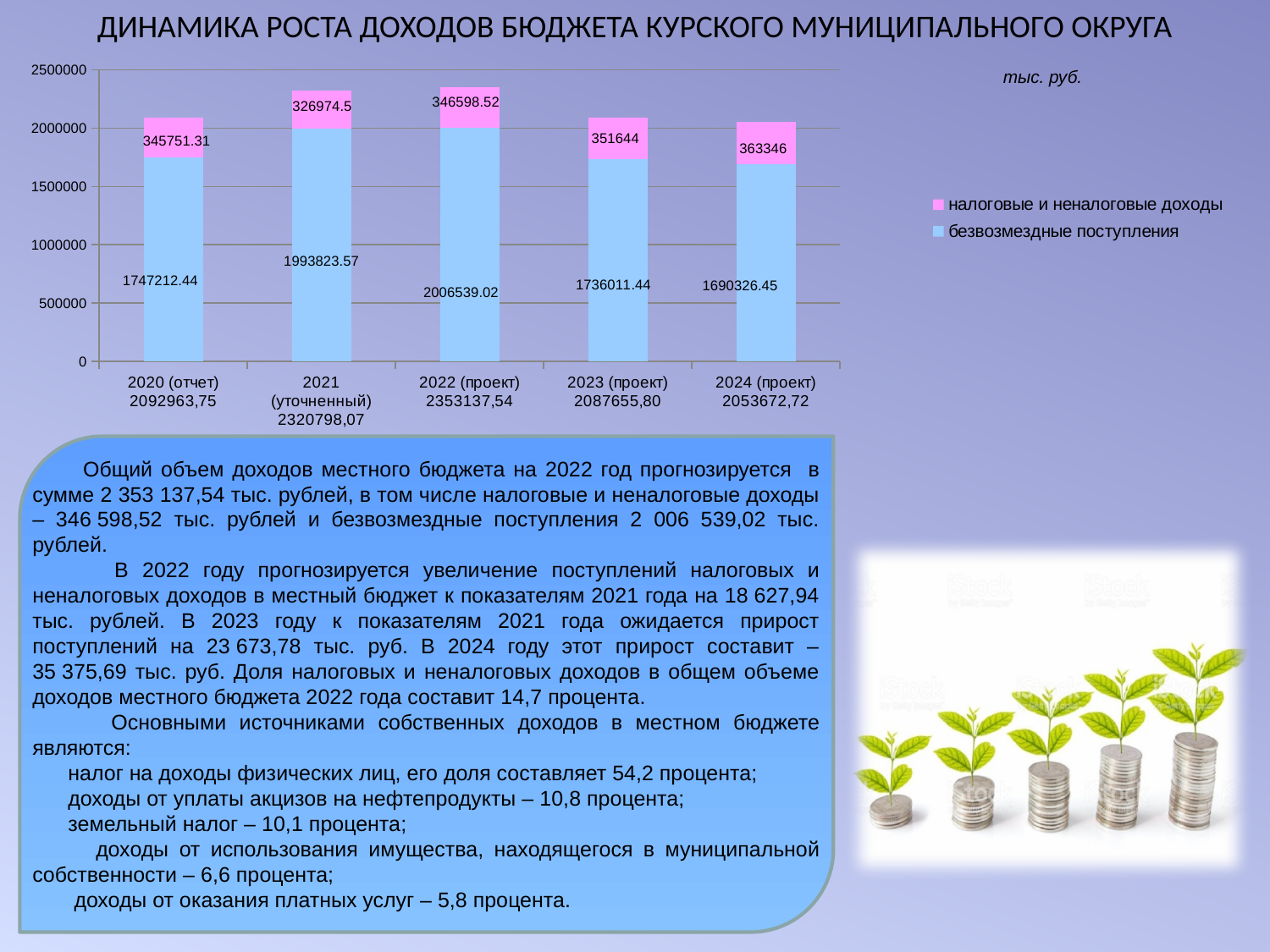
What is the value of безвозмездные поступления for 2022 (проект)? 2006539.02 Which colour represents безвозмездные поступления in the chart? blue What type of chart is shown on the slide? stacked bar chart Which is larger: безвозмездные поступления in 2021 (уточненный) or in 2023 (проект)? 2021 (уточненный) Is the total height of the 2021 (уточненный) bar greater or less than 2000000? greater Which year has the highest value for налоговые и неналоговые доходы? 2024 (проект) What is the total of the stacked bar for 2022 (проект), as printed under the category label? 2353137,54 How many series does the legend list? 2 How many categories (years) are shown on the x axis? 5 What is the value of налоговые и неналоговые доходы for 2020 (отчет)? 345751.31 Which year has the lowest value for безвозмездные поступления? 2024 (проект) What is the difference between налоговые и неналоговые доходы in 2024 (проект) and 2023 (проект)? 11702